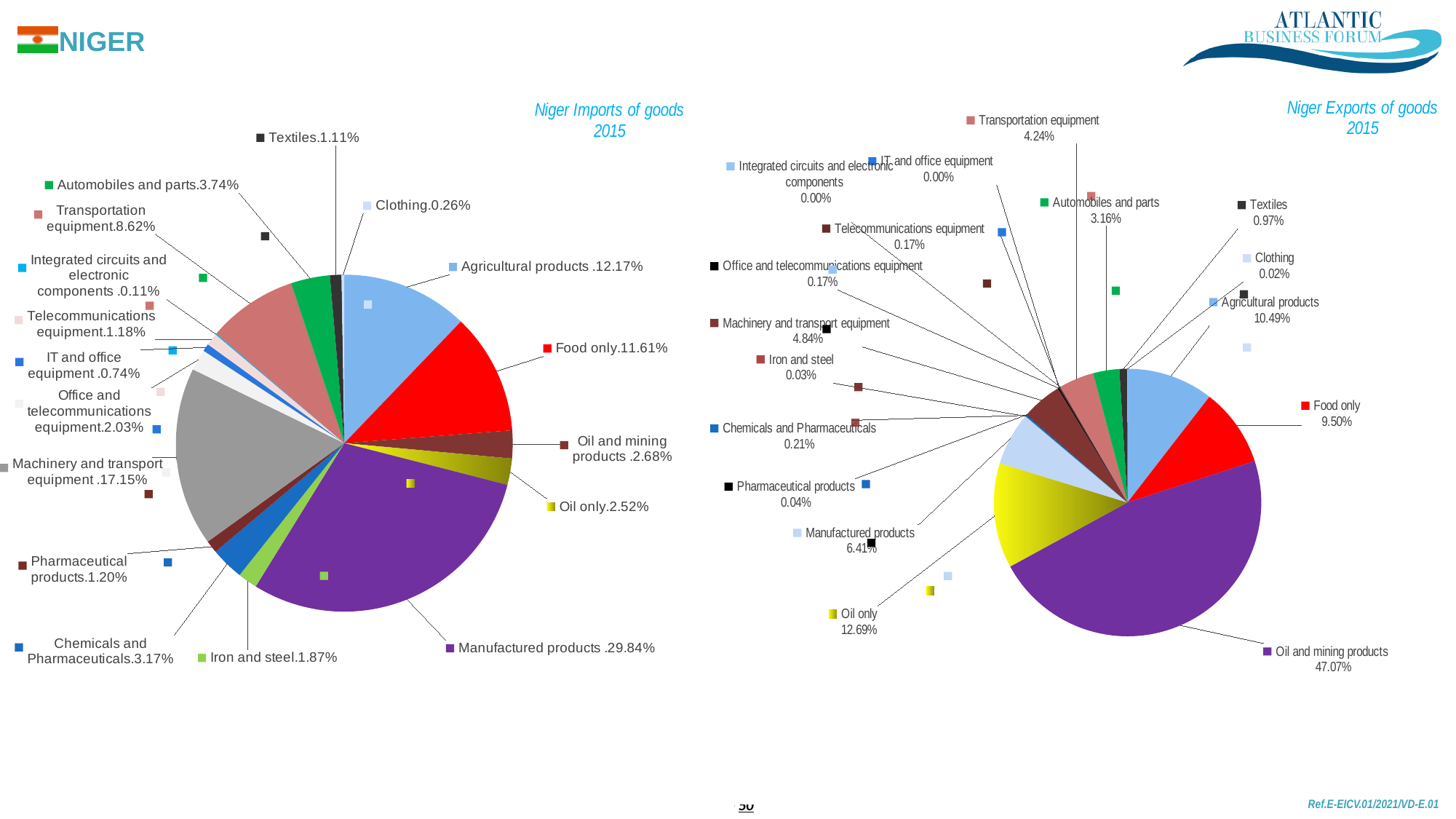
In the Niger Exports of goods 2015 chart, what is the value for Oil only? 12.69% In the Niger Exports of goods 2015 chart, which is larger: Agricultural products or Food only? Agricultural products In the Niger Imports of goods 2015 chart, which is larger: Transportation equipment or Automobiles and parts? Transportation equipment In the Niger Imports of goods 2015 chart, which category has the smallest share? Integrated circuits and electronic components In the Niger Imports of goods 2015 chart, what is the difference between Agricultural products and Food only? 0.56% In the Niger Imports of goods 2015 chart, what is the value for Machinery and transport equipment? 17.15% In the Niger Exports of goods 2015 chart, what share do Oil and mining products have? 47.07% What type of chart is used for Niger Imports of goods 2015? Pie chart In the Niger Imports of goods 2015 chart, which category has the largest share? Manufactured products In the Niger Exports of goods 2015 chart, what is the difference between Oil only and Manufactured products? 6.28% In the Niger Exports of goods 2015 chart, which category has the largest share? Oil and mining products In the Niger Imports of goods 2015 chart, what share do Manufactured products have? 29.84%